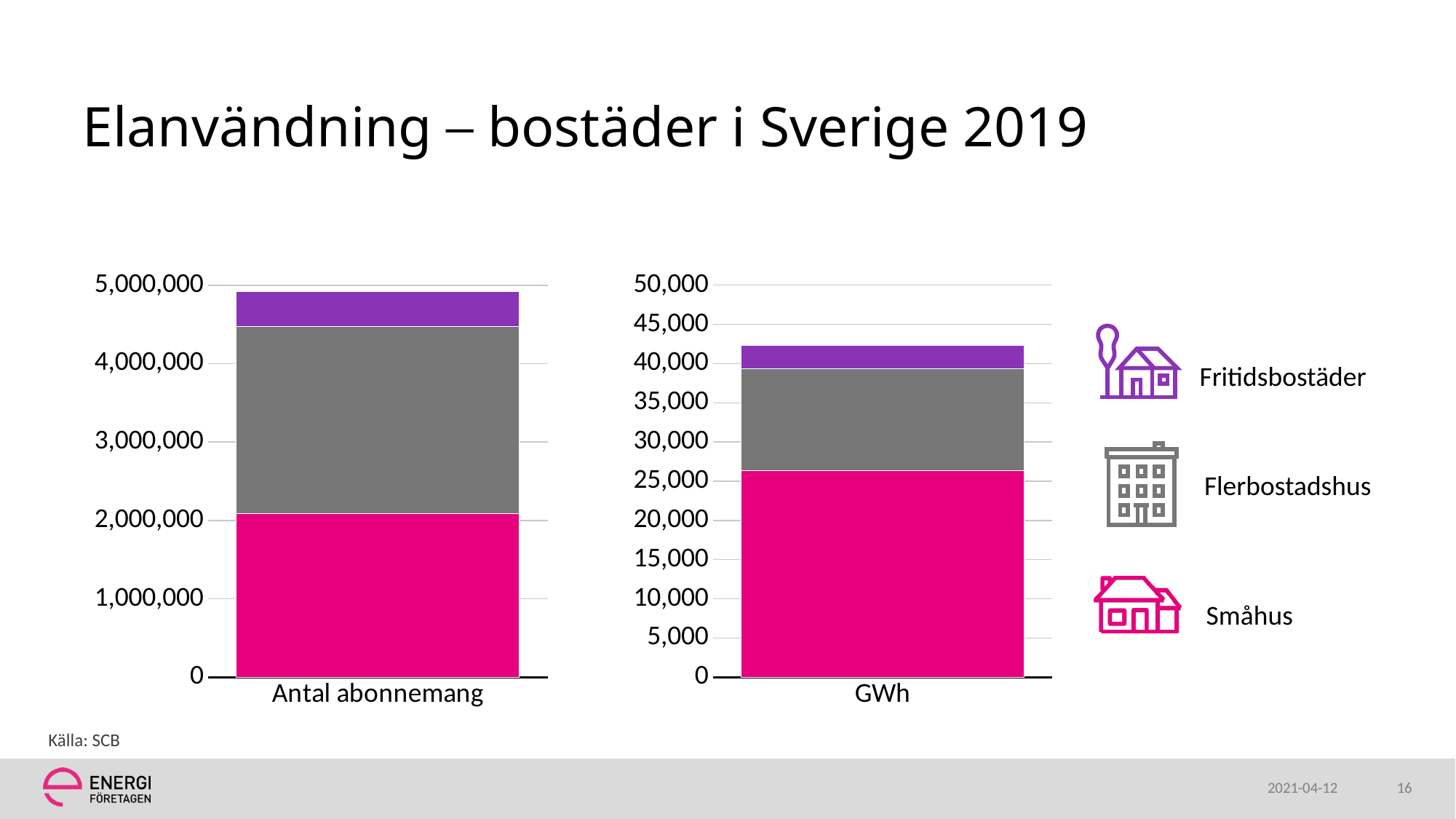
What kind of chart is the left chart (Antal abonnemang)? bar chart In the left chart (Antal abonnemang), which series has the smallest segment? Fritidsbostäder In the right chart (GWh), is the value for Småhus greater or less than 25,000? greater In the right chart (GWh), is the total of the stacked bar greater or less than 45,000? less In the left chart (Antal abonnemang), is the value for Småhus greater or less than 3,000,000? less How many series does the legend list? 3 Which colour represents Småhus in the charts? pink In the right chart (GWh), which series has the largest segment? Småhus How many categories are shown on the x axis of the right chart? 1 In the right chart (GWh), which series has the smallest segment? Fritidsbostäder In the right chart (GWh), which is larger, Småhus or Flerbostadshus? Småhus